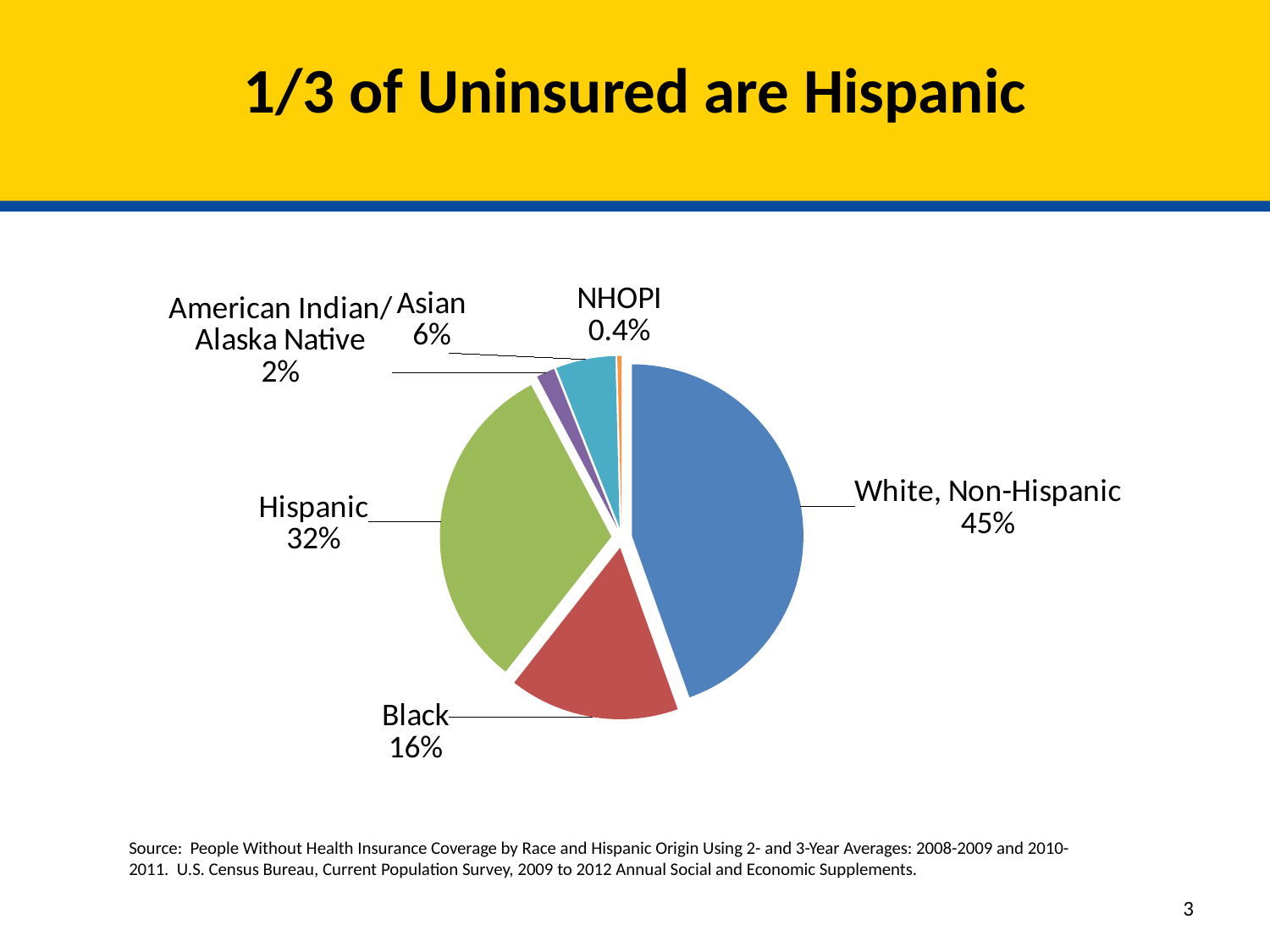
Which slice is larger, Black or Asian? Black What is the title of the slide containing the chart? 1/3 of Uninsured are Hispanic What is the difference in percentage points between the White, Non-Hispanic and Hispanic slices? 13 What is the value for American Indian/Alaska Native? 2% How many slices does the pie chart have? 6 What percentage of the pie chart is White, Non-Hispanic? 45% What share of the uninsured is Hispanic according to the pie chart? 32% What is the value shown for the Black slice? 16% What percentage is shown for the NHOPI slice? 0.4% What type of chart is shown on the slide? Pie chart Which group has the largest slice of the pie? White, Non-Hispanic Which group has the smallest slice of the pie? NHOPI